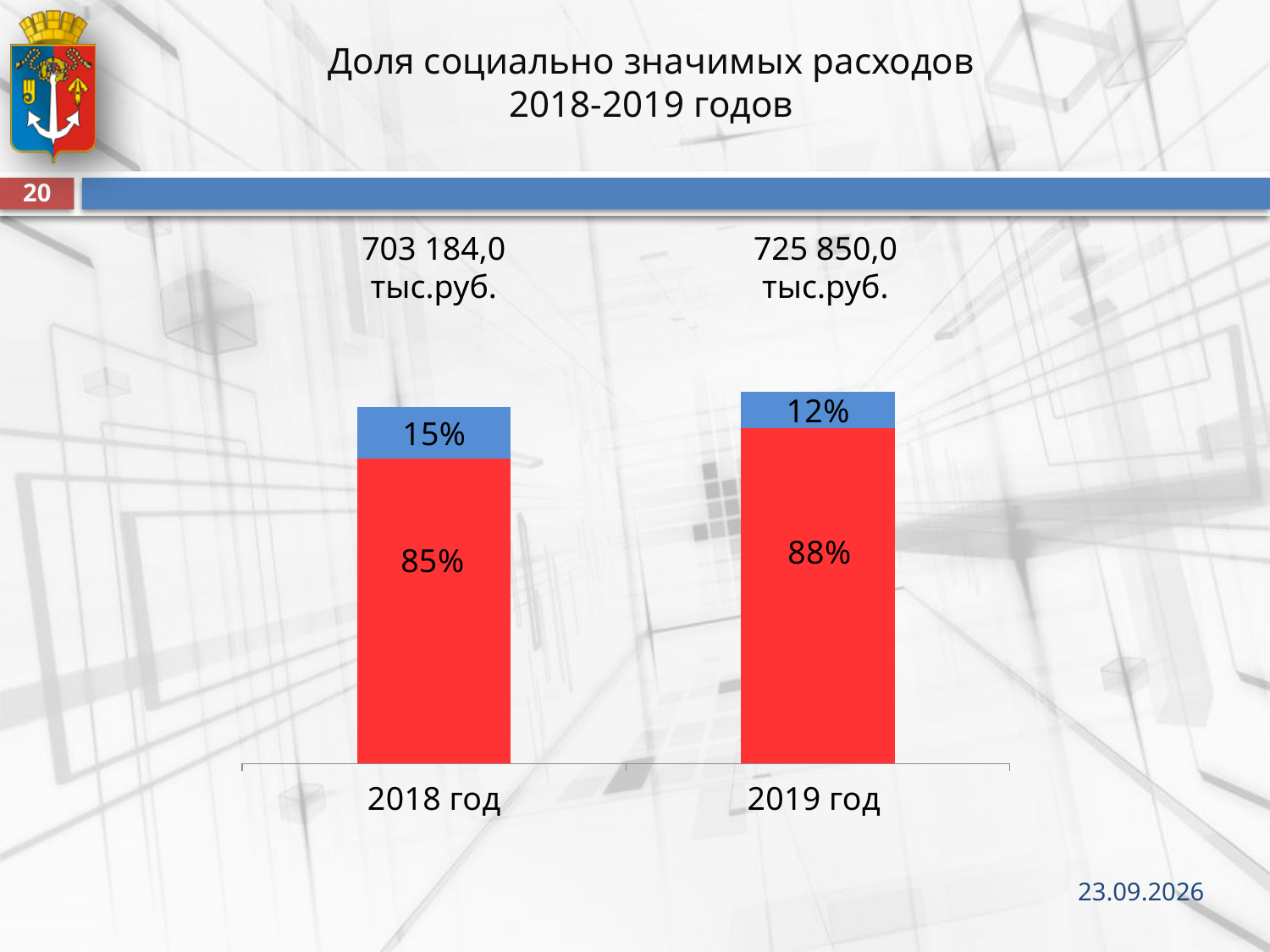
Which year has the larger red segment, 2018 год or 2019 год? 2019 год Which year has the smaller blue segment? 2019 год By how many percentage points does the red segment for 2019 год exceed the red segment for 2018 год? 3% What is the total of the stacked bar for 2018 год? 100% What is the value of the blue segment for 2019 год? 12% What amount in тыс.руб. is shown above the bar for 2019 год? 725 850,0 тыс.руб. What type of chart is shown on the slide? bar chart What is the value of the red segment for 2018 год? 85% How many categories are shown on the x axis of the chart? 2 What is the title of the chart on the slide? Доля социально значимых расходов 2018-2019 годов What is the value of the blue segment for 2018 год? 15% What is the value of the red segment for 2019 год? 88%